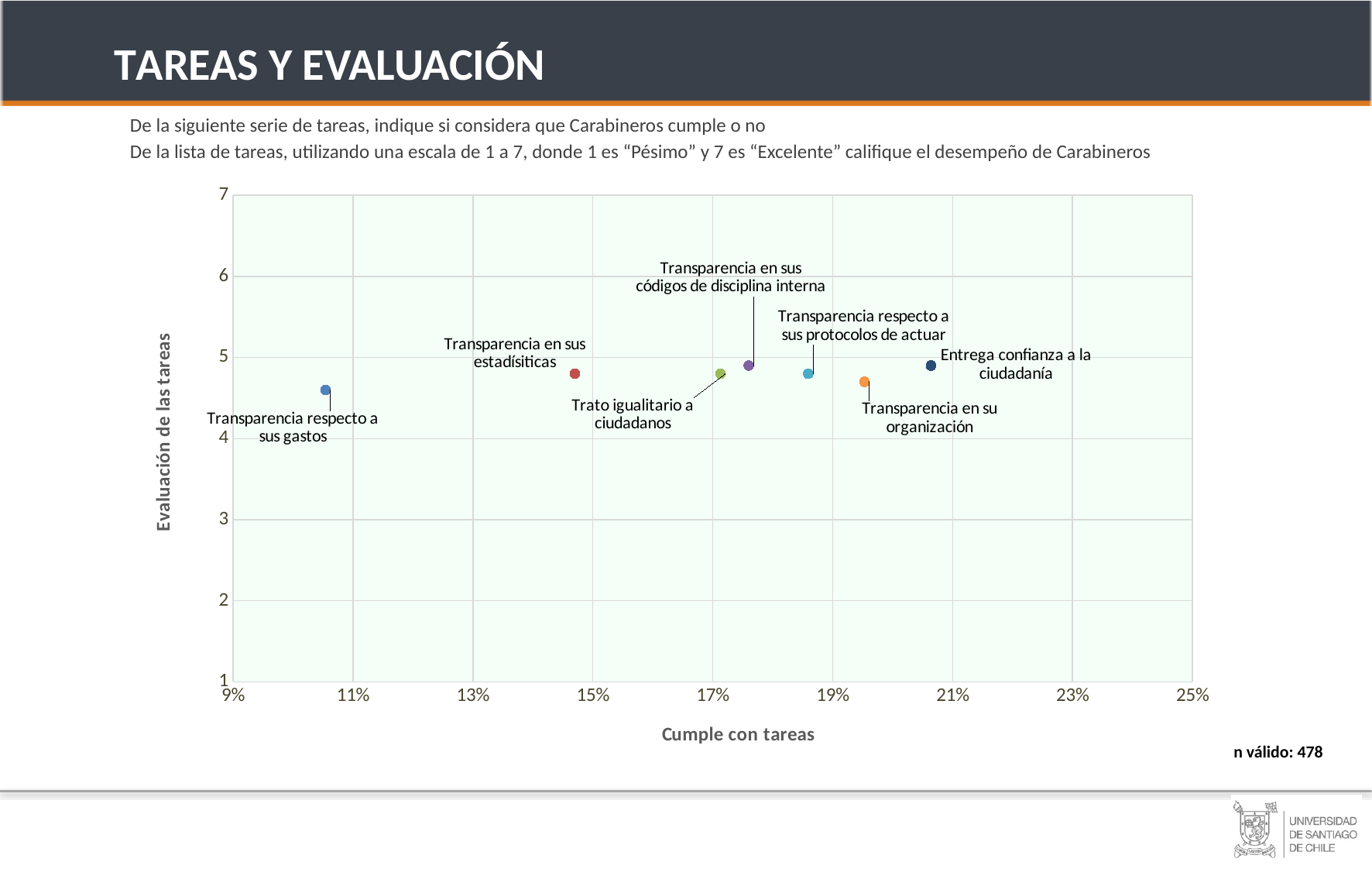
Which has a higher 'Evaluación de las tareas' value: 'Transparencia respecto a sus gastos' or 'Entrega confianza a la ciudadanía'? Entrega confianza a la ciudadanía Which has a higher 'Cumple con tareas' value: 'Transparencia en sus estadísiticas' or 'Transparencia en su organización'? Transparencia en su organización What is the title of the vertical axis of the chart? Evaluación de las tareas Is the 'Evaluación de las tareas' value for 'Transparencia en sus estadísiticas' greater or less than 5? less Is the 'Evaluación de las tareas' value for 'Transparencia en su organización' greater or less than 4? greater What is the title of the horizontal axis of the chart? Cumple con tareas How many data points are plotted in the chart? 7 Which task has the highest value on the 'Cumple con tareas' axis? Entrega confianza a la ciudadanía What kind of chart is shown on the slide? Scatter chart Which task has the lowest value on the 'Cumple con tareas' axis? Transparencia respecto a sus gastos Is the 'Cumple con tareas' value for 'Transparencia respecto a sus gastos' greater or less than 11%? less